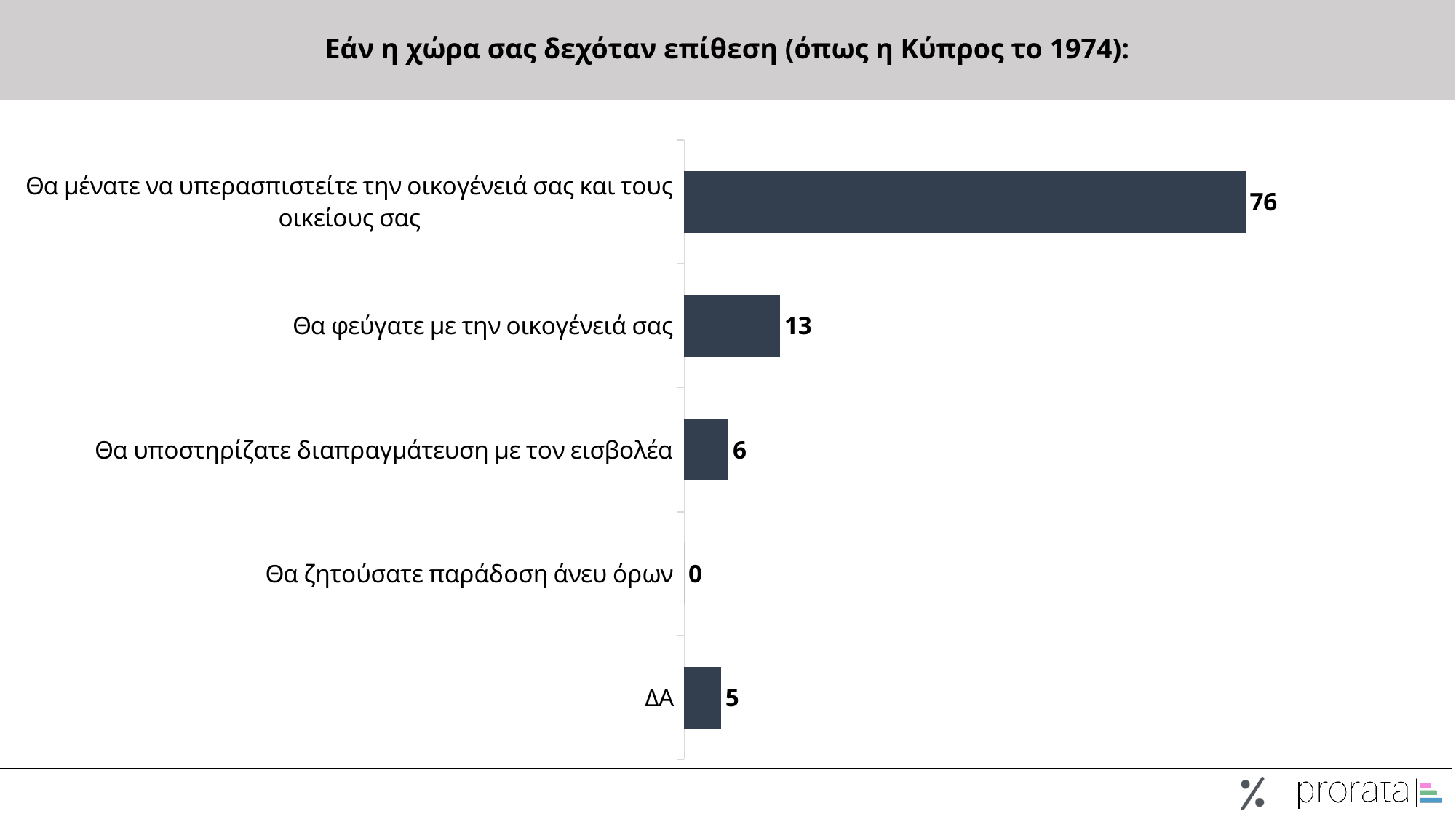
What is the value for 'Θα υποστηρίζατε διαπραγμάτευση με τον εισβολέα'? 6 What is the value for 'Θα ζητούσατε παράδοση άνευ όρων'? 0 What is the title of the chart? Εάν η χώρα σας δεχόταν επίθεση (όπως η Κύπρος το 1974): Which category has the highest value? Θα μένατε να υπερασπιστείτε την οικογένειά σας και τους οικείους σας What kind of chart is shown on the slide? Bar chart Which is larger: the value for 'Θα υποστηρίζατε διαπραγμάτευση με τον εισβολέα' or the value for 'ΔΑ'? Θα υποστηρίζατε διαπραγμάτευση με τον εισβολέα What is the difference between the values for 'Θα μένατε να υπερασπιστείτε την οικογένειά σας και τους οικείους σας' and 'Θα φεύγατε με την οικογένειά σας'? 63 What is the value for 'ΔΑ'? 5 Which category has the lowest value? Θα ζητούσατε παράδοση άνευ όρων What is the value for 'Θα φεύγατε με την οικογένειά σας'? 13 How many categories are shown in the chart? 5 What is the value for 'Θα μένατε να υπερασπιστείτε την οικογένειά σας και τους οικείους σας'? 76